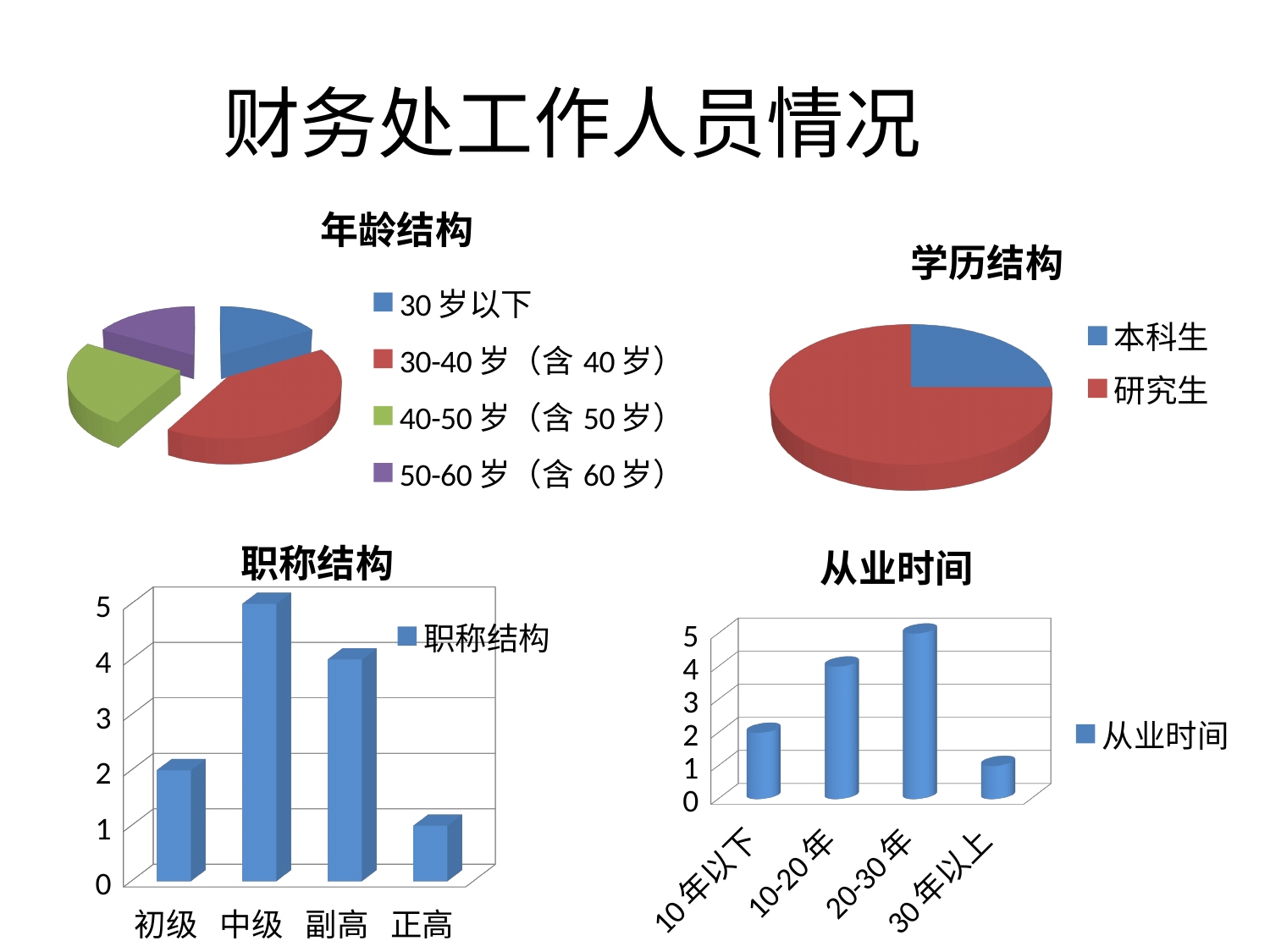
How many slices does the 学历结构 pie chart have? 2 How many categories does the legend of the 年龄结构 chart list? 4 In the 职称结构 chart, which category has the lowest value? 正高 In the 年龄结构 chart, which age group has the largest slice? 30-40 岁（含 40 岁） In the 学历结构 chart, which category has the larger share, 本科生 or 研究生? 研究生 In the 从业时间 chart, is the value for 10 年以下 greater or less than 3? less What kind of chart is the 职称结构 chart? bar chart In the 职称结构 chart, what is the value for 副高? 4 In the 职称结构 chart, which category has the highest value? 中级 In the 从业时间 chart, which category has the highest value? 20-30 年 What kind of chart is the 年龄结构 chart? pie chart How many categories are shown on the x axis of the 从业时间 chart? 4